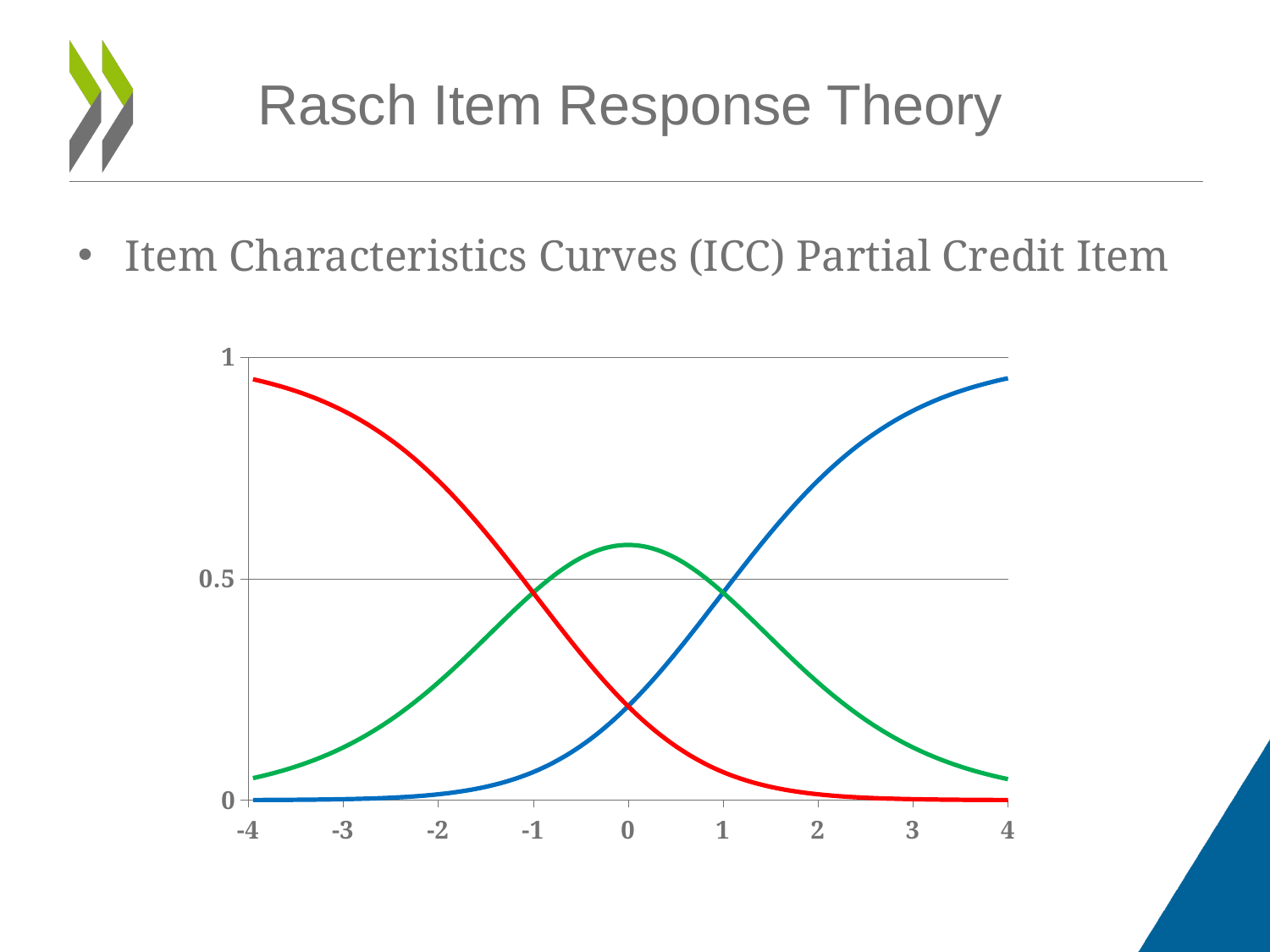
What are the lowest and highest values labelled on the x axis? -4 and 4 At x = 4, which curve has the higher value, the blue curve or the green curve? blue curve Is the value of the blue curve at x = 4 greater or less than 0.5? greater Is the value of the red curve at x = -4 greater or less than 0.5? greater Is the value of the green curve at x = -4 greater or less than 0.5? less At x = -4, which curve has the higher value, the red curve or the green curve? red curve Which curve reaches its peak at x = 0? green curve Does the blue curve rise or fall as the x axis goes from -4 to 4? rise Does the red curve rise or fall as the x axis goes from -4 to 4? fall What kind of chart is shown on the slide? line chart How many curves are plotted on the chart? 3